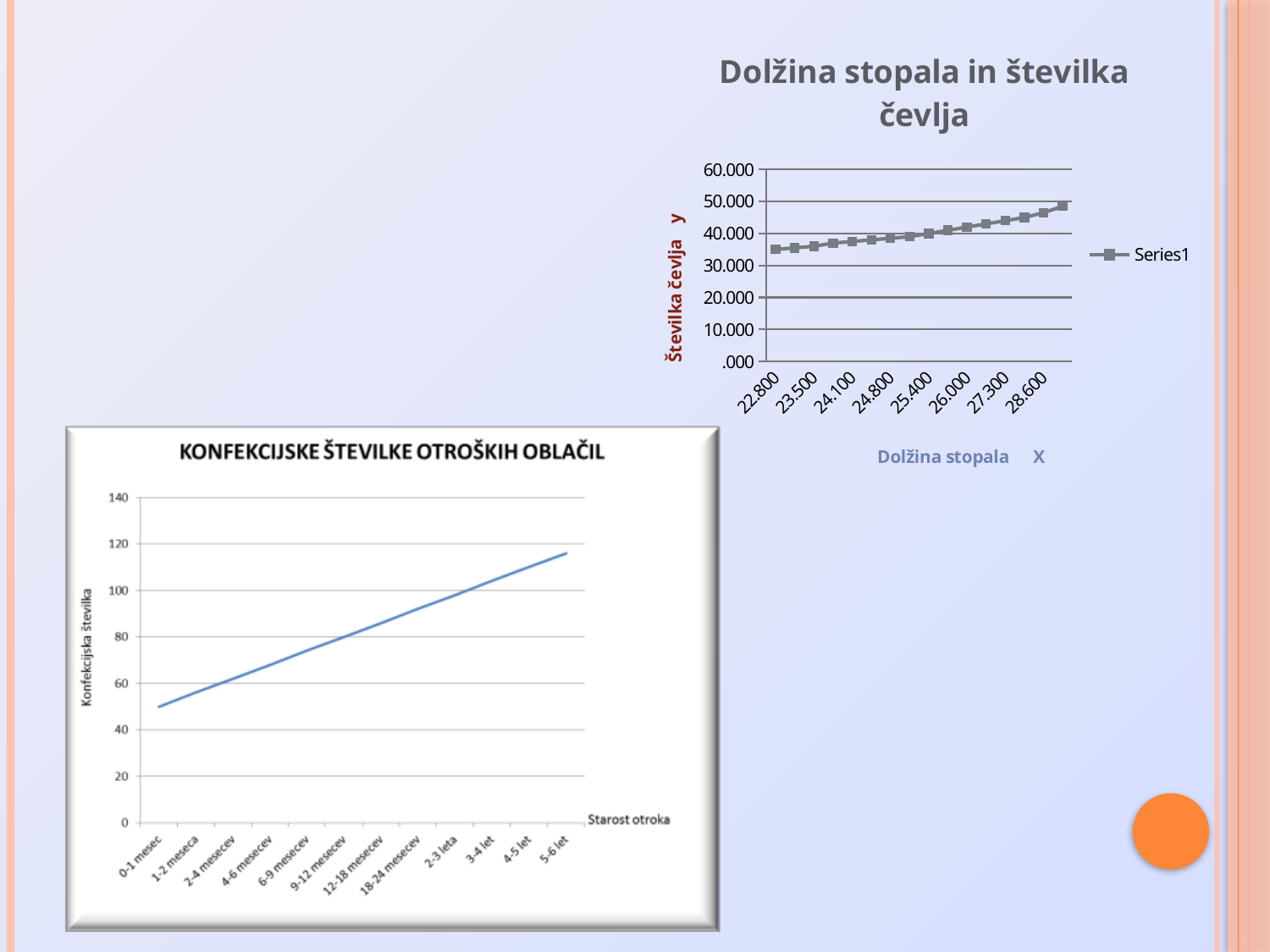
In the chart titled "Dolžina stopala in številka čevlja", what is the title of the vertical axis? Številka čevlja y In the chart titled "KONFEKCIJSKE ŠTEVILKE OTROŠKIH OBLAČIL", how many age categories are shown on the x axis? 12 In the chart titled "Dolžina stopala in številka čevlja", what is the name of the series shown in the legend? Series1 What type of chart is the chart titled "Dolžina stopala in številka čevlja"? line chart In the chart titled "Dolžina stopala in številka čevlja", is the value at 22.800 greater or less than 40.000? less What type of chart is the chart titled "KONFEKCIJSKE ŠTEVILKE OTROŠKIH OBLAČIL"? line chart In the chart titled "KONFEKCIJSKE ŠTEVILKE OTROŠKIH OBLAČIL", do the values rise or fall as the child's age increases along the x axis? rise In the chart titled "Dolžina stopala in številka čevlja", do the values rise or fall as the foot length increases along the x axis? rise In the chart titled "KONFEKCIJSKE ŠTEVILKE OTROŠKIH OBLAČIL", is the value for 5-6 let greater or less than 100? greater In the chart titled "Dolžina stopala in številka čevlja", how many series does the legend list? 1 In the chart titled "Dolžina stopala in številka čevlja", is the value at 28.600 greater or less than 40.000? greater